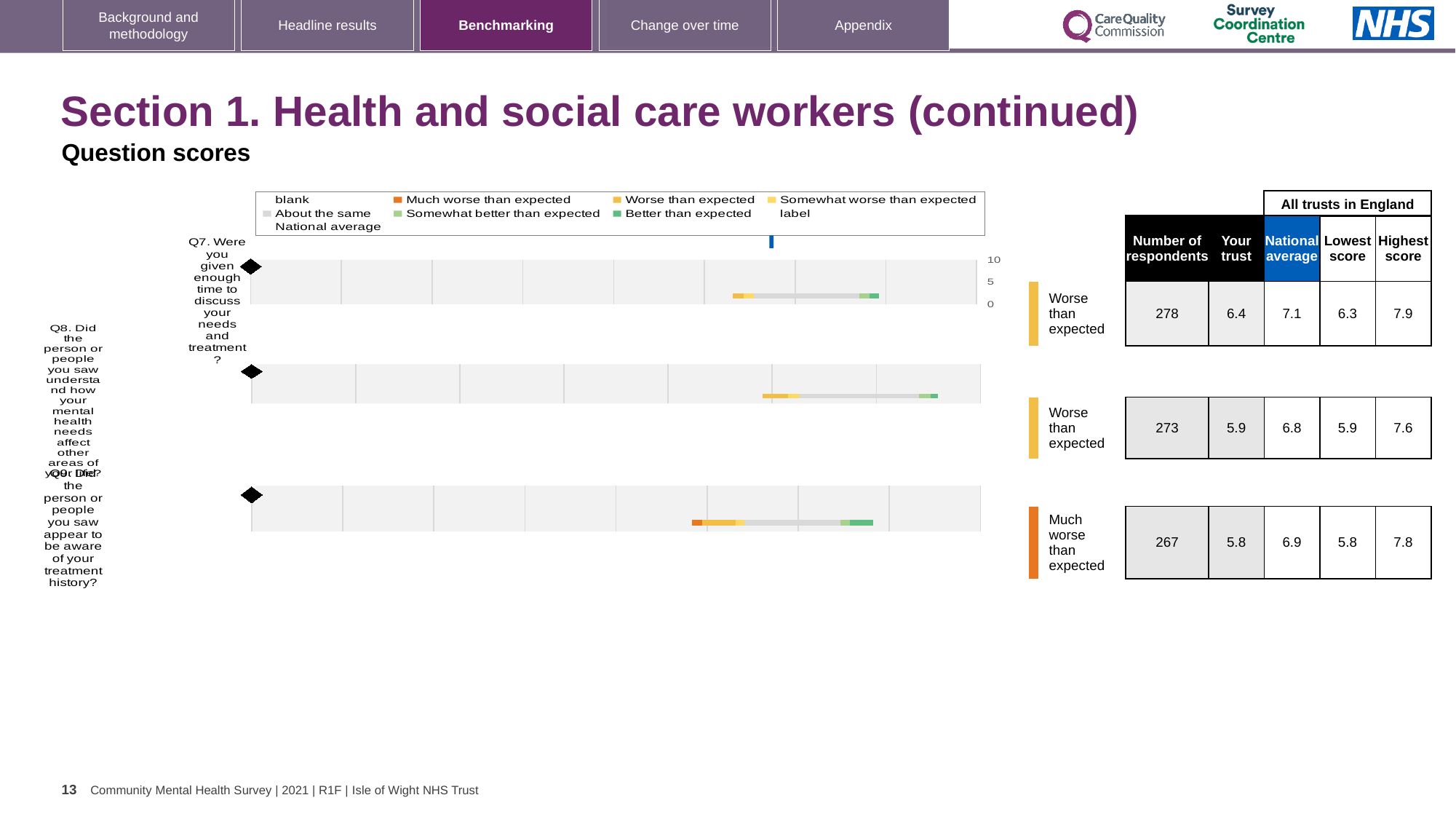
For Q8, which is larger: the 'Your trust' score or the national average? National average Which question has the largest number of respondents? Q7 For Q9 (Did the person or people you saw appear to be aware of your treatment history?), what is the highest score among all trusts in England? 7.8 How many questions (Q7, Q8, Q9) are plotted on the slide? 3 What benchmark category is shown for Q9? Much worse than expected For Q8 (Did the person or people you saw understand how your mental health needs affect other areas of your life?), how many respondents were there? 273 Which question has the lowest 'Your trust' score? Q9 Which question has the highest 'Your trust' score? Q7 For Q7, what is the difference between the national average and the 'Your trust' score? 0.7 For Q7 (Were you given enough time to discuss your needs and treatment?), what is the 'Your trust' score? 6.4 For Q7, what is the national average score? 7.1 What kind of chart is used to show the question scores on this slide? bar chart